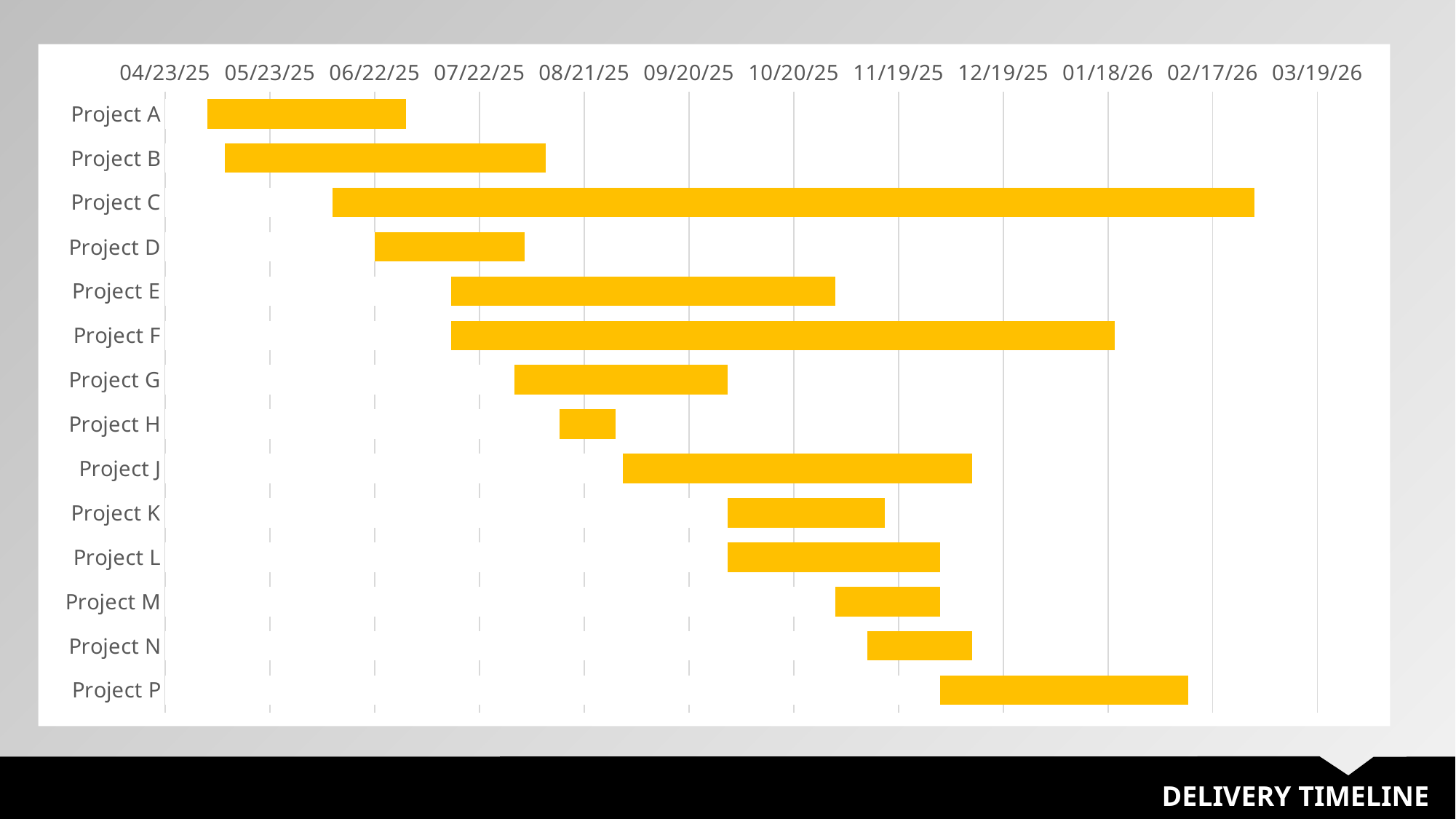
Does Project C end before or after 02/17/26? after Does Project H start before or after 07/22/25? after Which project starts latest on the timeline? Project P Which bar is longer, Project J or Project K? Project J What is the title shown at the bottom of the slide? DELIVERY TIMELINE How many projects are listed on the chart? 14 Which project has the shortest bar on the timeline? Project H Does Project B end before or after 08/21/25? before What kind of chart is shown on the slide? Bar chart (Gantt chart) Which project starts earliest on the timeline? Project A Which project has the longest bar on the timeline? Project C Which bar is longer, Project C or Project D? Project C